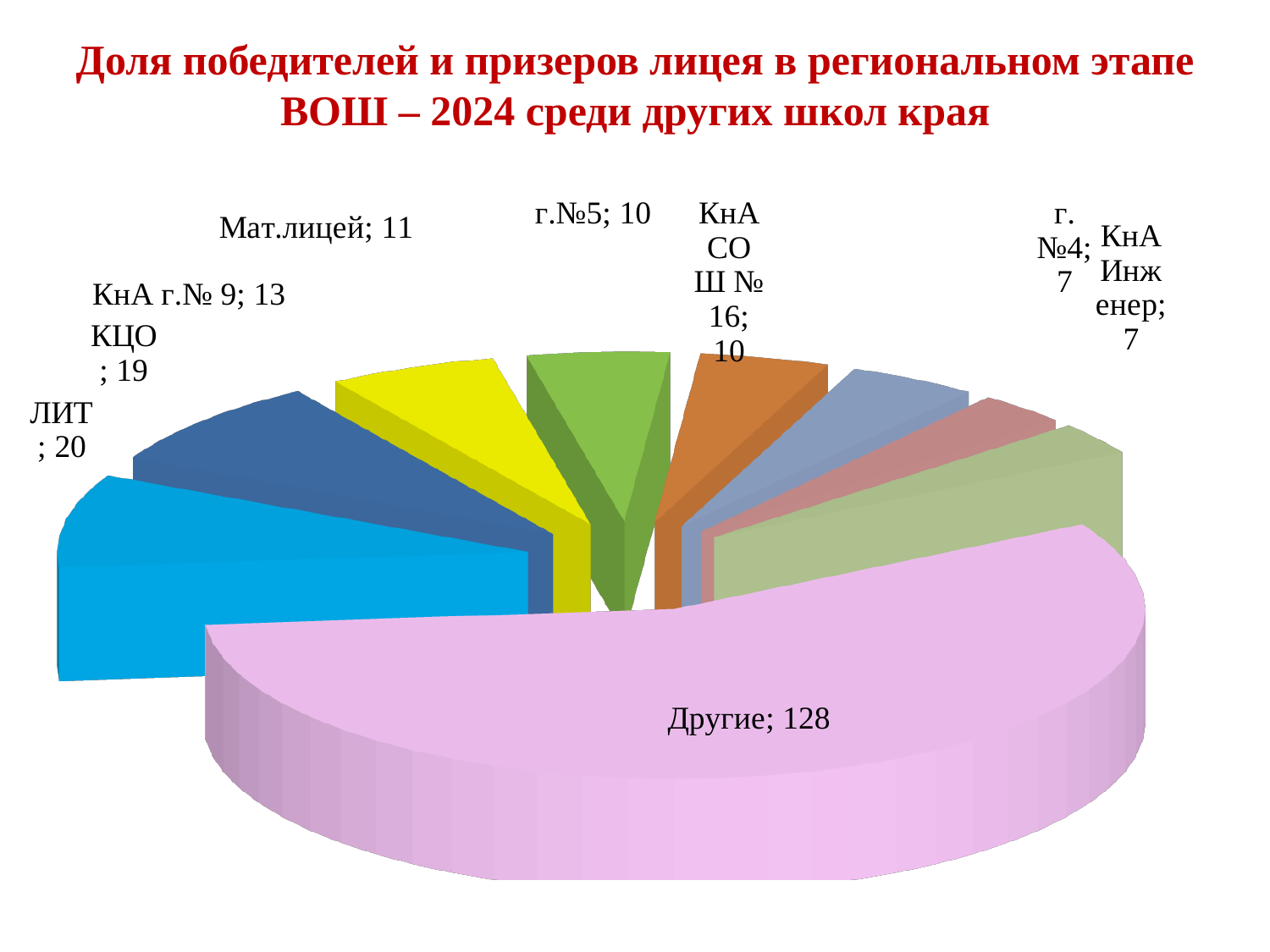
What value is shown for the Другие slice? 128 What value is shown for the ЛИТ slice? 20 What value is shown for Мат.лицей? 11 What value is shown for КнА г.№ 9? 13 Which has the larger value, ЛИТ or КЦО? ЛИТ How many slices does the pie chart have? 9 Which two slices share the smallest value of 7? г.№4 and КнА Инженер Which slice has the largest value? Другие What is the total of all the slice values in the pie chart? 225 What kind of chart is shown on the slide? Pie chart What value is shown for the КЦО slice? 19 What is the difference between the values for Другие and ЛИТ? 108